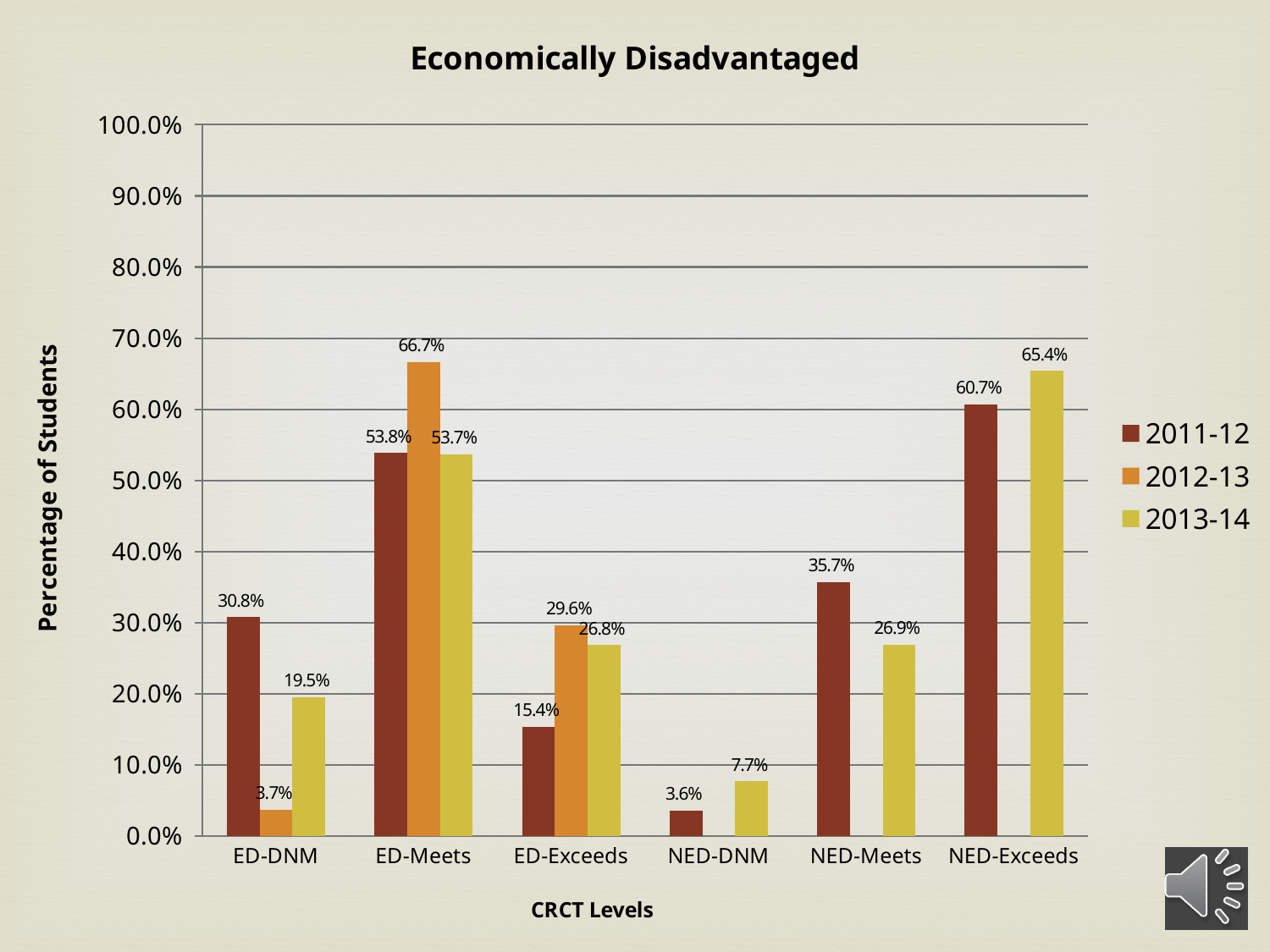
Is the value for 2013-14 in the ED-Exceeds category greater or less than 30%? less In the NED-Meets category, which series has the larger value, 2011-12 or 2013-14? 2011-12 How many categories are shown on the x axis? 6 Which category has the highest value for the 2011-12 series? NED-Exceeds How many series does the legend list? 3 What is the value for 2013-14 in the NED-Exceeds category? 65.4% What is the value for 2011-12 in the ED-DNM category? 30.8% What is the title of the chart? Economically Disadvantaged What is the difference between the 2012-13 and 2011-12 values in the ED-Meets category? 12.9% Which category has the lowest value for the 2013-14 series? NED-DNM What is the value for 2012-13 in the ED-Meets category? 66.7% What kind of chart is shown on the slide? bar chart